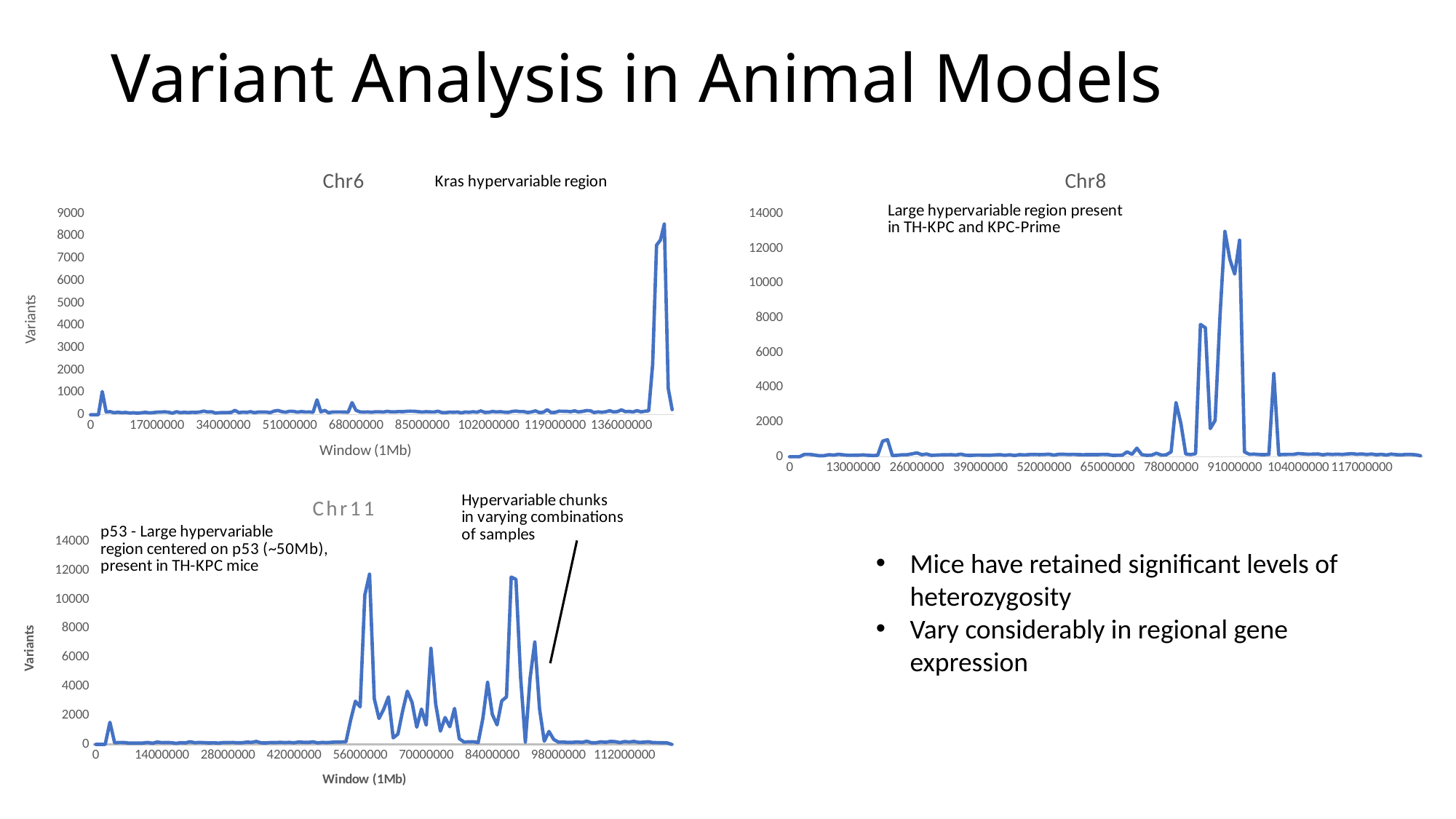
On the Chr6 chart, is the value at the 17000000 window greater or less than 1000? less What kind of chart is the Chr11 chart? line chart On the Chr8 chart, is the value at the tallest peak greater or less than 12000? greater On the Chr6 chart, is the value at the 68000000 window greater or less than 1000? less On the Chr6 chart, what is the label on the vertical axis? Variants How many charts are shown on the slide? 3 What kind of chart is the Chr6 chart? line chart